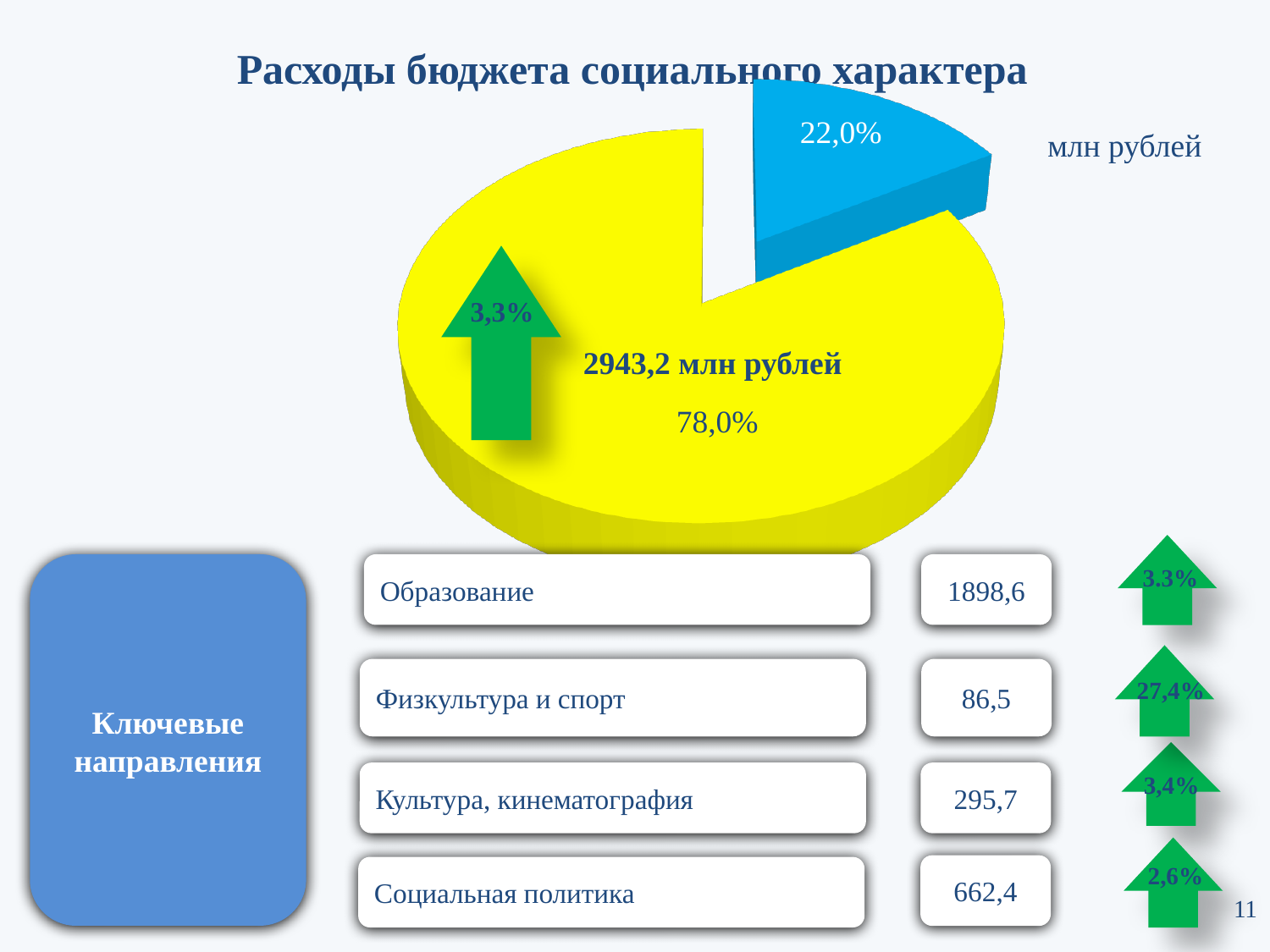
What kind of chart is shown on the slide? pie chart What value in млн рублей is printed on the yellow slice of the pie chart? 2943,2 млн рублей Is the share of the blue slice greater or less than 25%? less What share of the pie does the blue slice represent? 22,0% Which slice of the pie chart is the smallest? the blue slice (22,0%) What share of the pie does the yellow slice represent? 78,0% What is the title of the slide above the pie chart? Расходы бюджета социального характера By how many percentage points does the yellow slice's share exceed the blue slice's share? 56,0 percentage points Which slice is larger, the yellow one or the blue one? the yellow one Which slice of the pie chart is the largest? the yellow slice (78,0%) How many slices does the pie chart have? 2 What percentage is shown on the green arrow next to the yellow slice of the pie chart? 3,3%